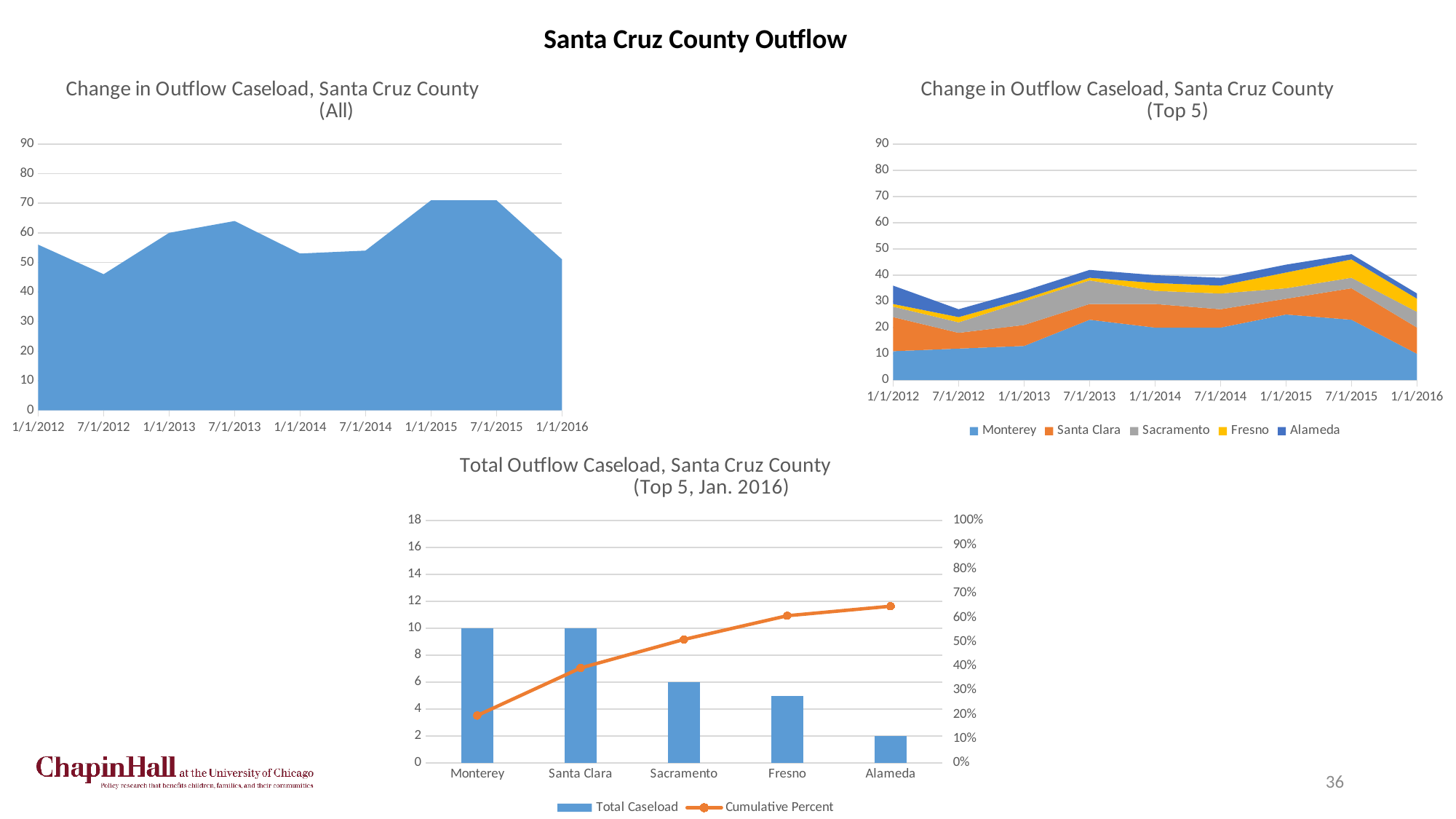
In the 'Total Outflow Caseload, Santa Cruz County (Top 5, Jan. 2016)' chart, which county has the lowest Total Caseload? Alameda How many series does the legend of the 'Change in Outflow Caseload, Santa Cruz County (Top 5)' chart list? 5 Which series are listed in the legend of the 'Total Outflow Caseload, Santa Cruz County (Top 5, Jan. 2016)' chart? Total Caseload and Cumulative Percent In the 'Total Outflow Caseload, Santa Cruz County (Top 5, Jan. 2016)' chart, which has a larger Total Caseload, Sacramento or Alameda? Sacramento How many counties are shown on the x axis of the 'Total Outflow Caseload, Santa Cruz County (Top 5, Jan. 2016)' chart? 5 In the 'Change in Outflow Caseload, Santa Cruz County (All)' chart, do values rise or fall from 7/1/2015 to 1/1/2016? fall In the 'Total Outflow Caseload, Santa Cruz County (Top 5, Jan. 2016)' chart, what is the difference between the Total Caseload for Monterey and Alameda? 8 In the 'Total Outflow Caseload, Santa Cruz County (Top 5, Jan. 2016)' chart, what is the Total Caseload for Monterey? 10 In the 'Total Outflow Caseload, Santa Cruz County (Top 5, Jan. 2016)' chart, what is the Total Caseload for Sacramento? 6 In the 'Total Outflow Caseload, Santa Cruz County (Top 5, Jan. 2016)' chart, what is the Total Caseload for Alameda? 2 In the 'Total Outflow Caseload, Santa Cruz County (Top 5, Jan. 2016)' chart, is the Total Caseload for Fresno greater or less than 4? greater In the 'Change in Outflow Caseload, Santa Cruz County (All)' chart, is the value for 1/1/2015 greater or less than 60? greater